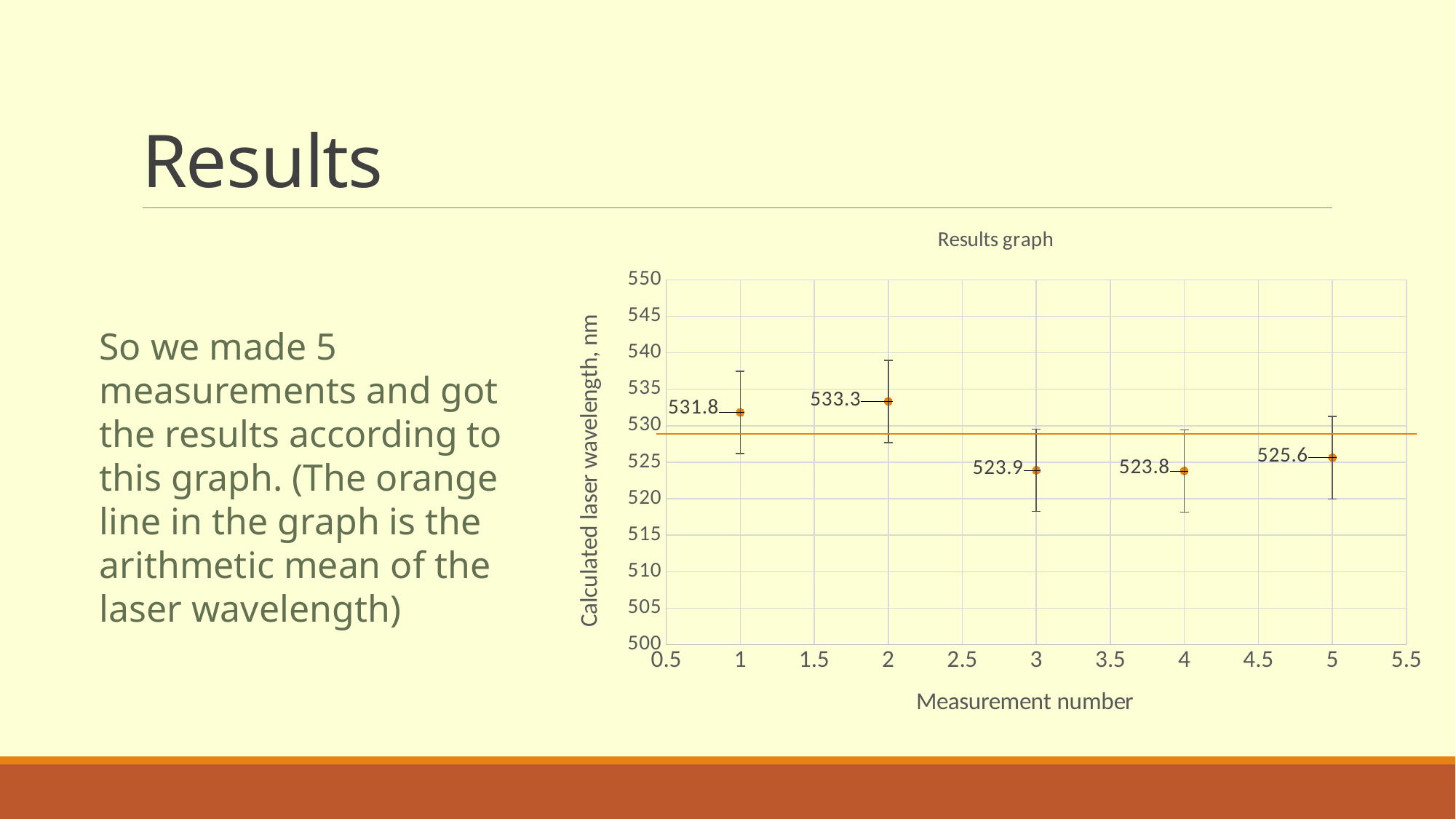
How many measurement points are plotted in the chart? 5 What kind of chart is shown on the slide? Scatter chart What is the calculated laser wavelength for measurement number 5? 525.6 Which measurement number has the lowest calculated laser wavelength? 4 Which has a larger calculated laser wavelength, measurement 1 or measurement 3? Measurement 1 What is the difference between the calculated wavelengths for measurement 2 and measurement 1? 1.5 What is the calculated laser wavelength for measurement number 4? 523.8 Which measurement number has the highest calculated laser wavelength? 2 Is the calculated laser wavelength for measurement 3 greater or less than 525? less What is the title of the chart? Results graph What is the calculated laser wavelength for measurement number 2? 533.3 What is the difference between the calculated wavelengths for measurement 1 and measurement 4? 8.0